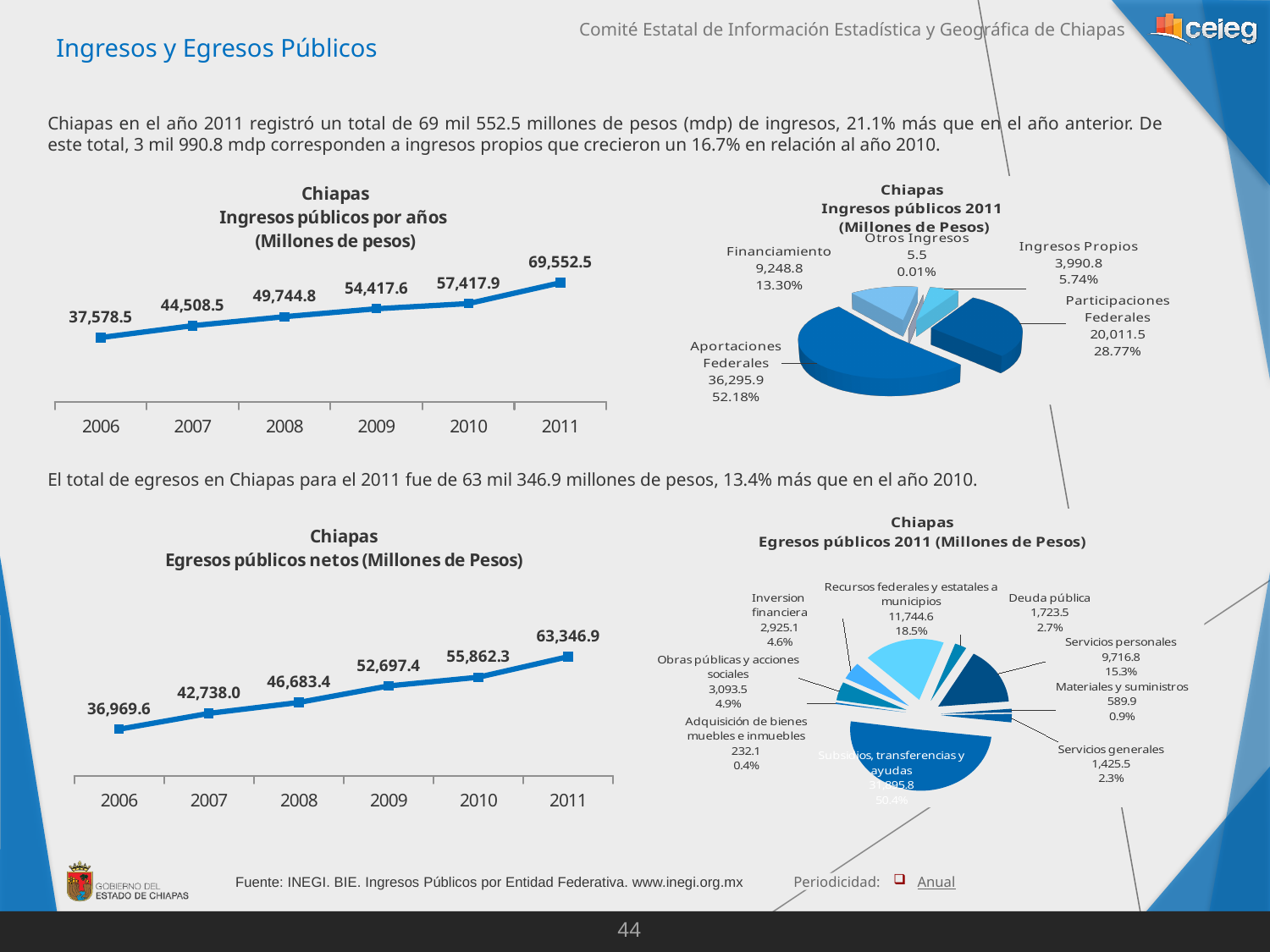
In the 'Ingresos públicos 2011' pie chart, what share do Aportaciones Federales represent? 52.18% In the 'Egresos públicos 2011' pie chart, which is larger: Servicios personales or Deuda pública? Servicios personales In the 'Egresos públicos 2011' pie chart, what share do Recursos federales y estatales a municipios represent? 18.5% In the 'Ingresos públicos por años' chart, what was the value for 2011? 69,552.5 What kind of chart is the 'Ingresos públicos 2011' chart? pie chart In the 'Ingresos públicos por años' chart, do the values rise or fall from 2006 to 2011? rise How many years are plotted in the 'Egresos públicos netos' chart? 6 In the 'Egresos públicos netos' chart, what was the value for 2008? 46,683.4 In the 'Ingresos públicos por años' chart, what is the difference between the 2011 and 2010 values? 12,134.6 In the 'Ingresos públicos 2011' pie chart, what is the value for Participaciones Federales? 20,011.5 In the 'Ingresos públicos 2011' pie chart, which category has the smallest value? Otros Ingresos In the 'Ingresos públicos por años' chart, what was the value for 2006? 37,578.5